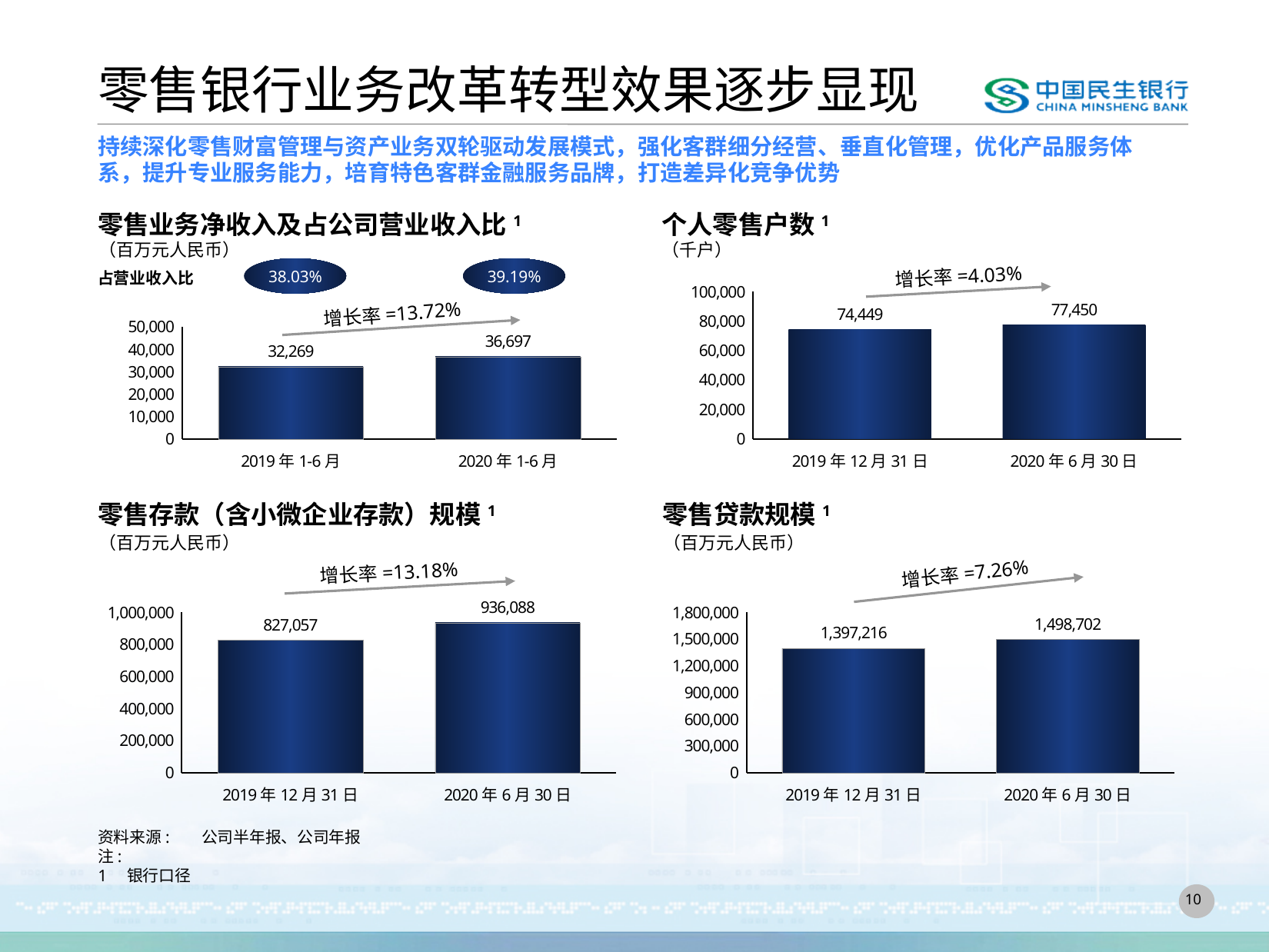
In the top-left chart (零售业务净收入及占公司营业收入比), what is the value for 2019年1-6月? 32,269 In the top-right chart (个人零售户数), which period has the higher value? 2020年6月30日 In the top-left chart, what growth rate (增长率) is shown above the bars? 13.72% In the top-right chart (个人零售户数), what is the difference between the 2020年6月30日 and 2019年12月31日 values? 3,001 In the bottom-right chart (零售贷款规模), what is the value for 2019年12月31日? 1,397,216 In the bottom-right chart (零售贷款规模), is the value for 2020年6月30日 greater or less than 1,200,000? greater In the bottom-left chart (零售存款（含小微企业存款）规模), what is the difference between the 2020年6月30日 and 2019年12月31日 values? 109,031 In the top-left chart (零售业务净收入及占公司营业收入比), what is the value for 2020年1-6月? 36,697 In the bottom-left chart (零售存款（含小微企业存款）规模), what is the value for 2020年6月30日? 936,088 In the top-right chart (个人零售户数), what is the value for 2019年12月31日? 74,449 What kind of chart is the bottom-right chart (零售贷款规模)? bar chart In the top-left chart (零售业务净收入及占公司营业收入比), what is the difference between the 2020年1-6月 and 2019年1-6月 values? 4,428